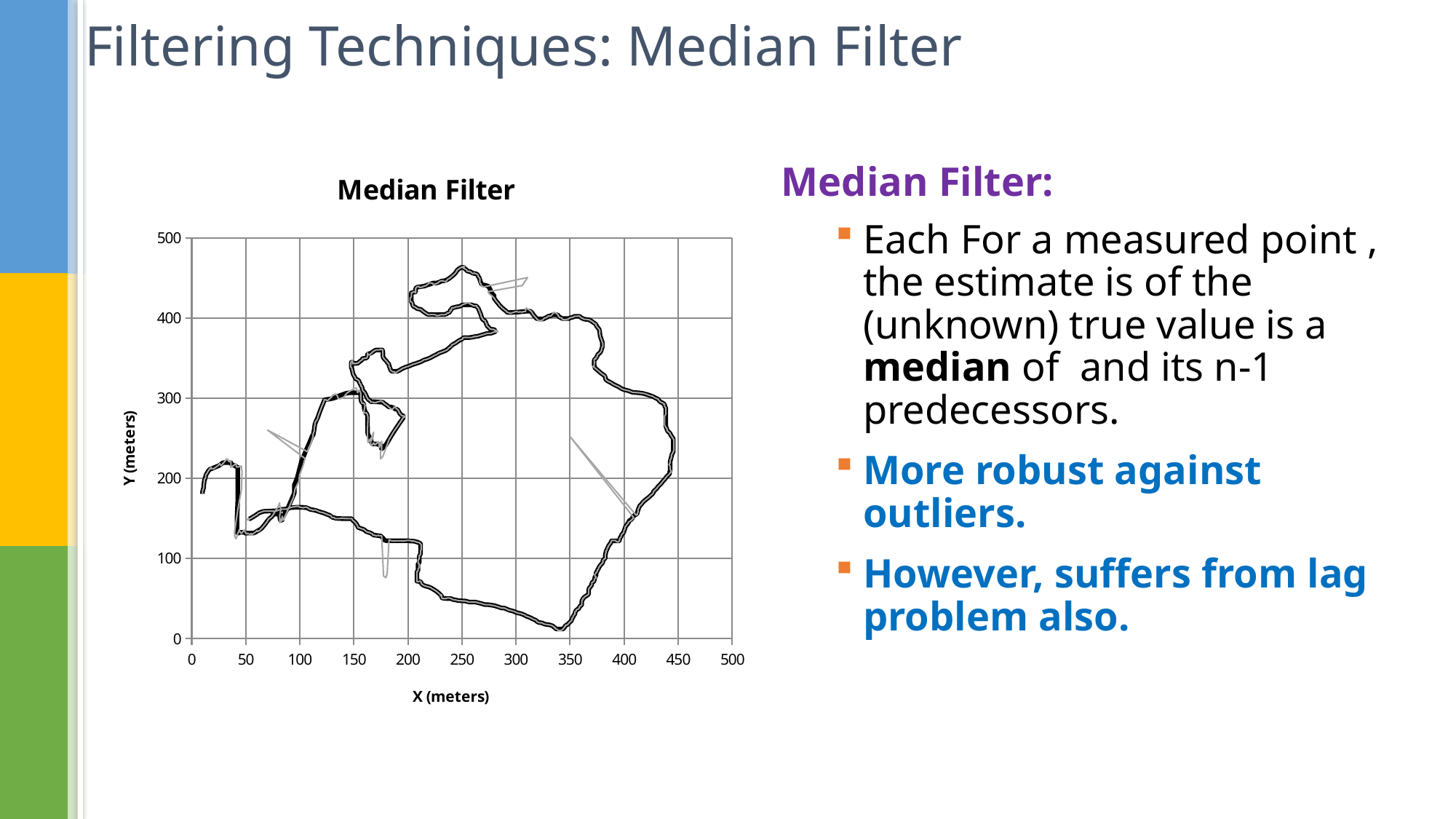
What is the label of the horizontal axis of the chart? X (meters) What kind of chart is shown on the slide? line chart Is the lowest Y value reached by the plotted path greater or less than 50? less Is the highest Y value reached by the plotted path greater or less than 400? greater What is the title of the chart on the slide? Median Filter Is the largest X value reached by the plotted path greater or less than 400? greater